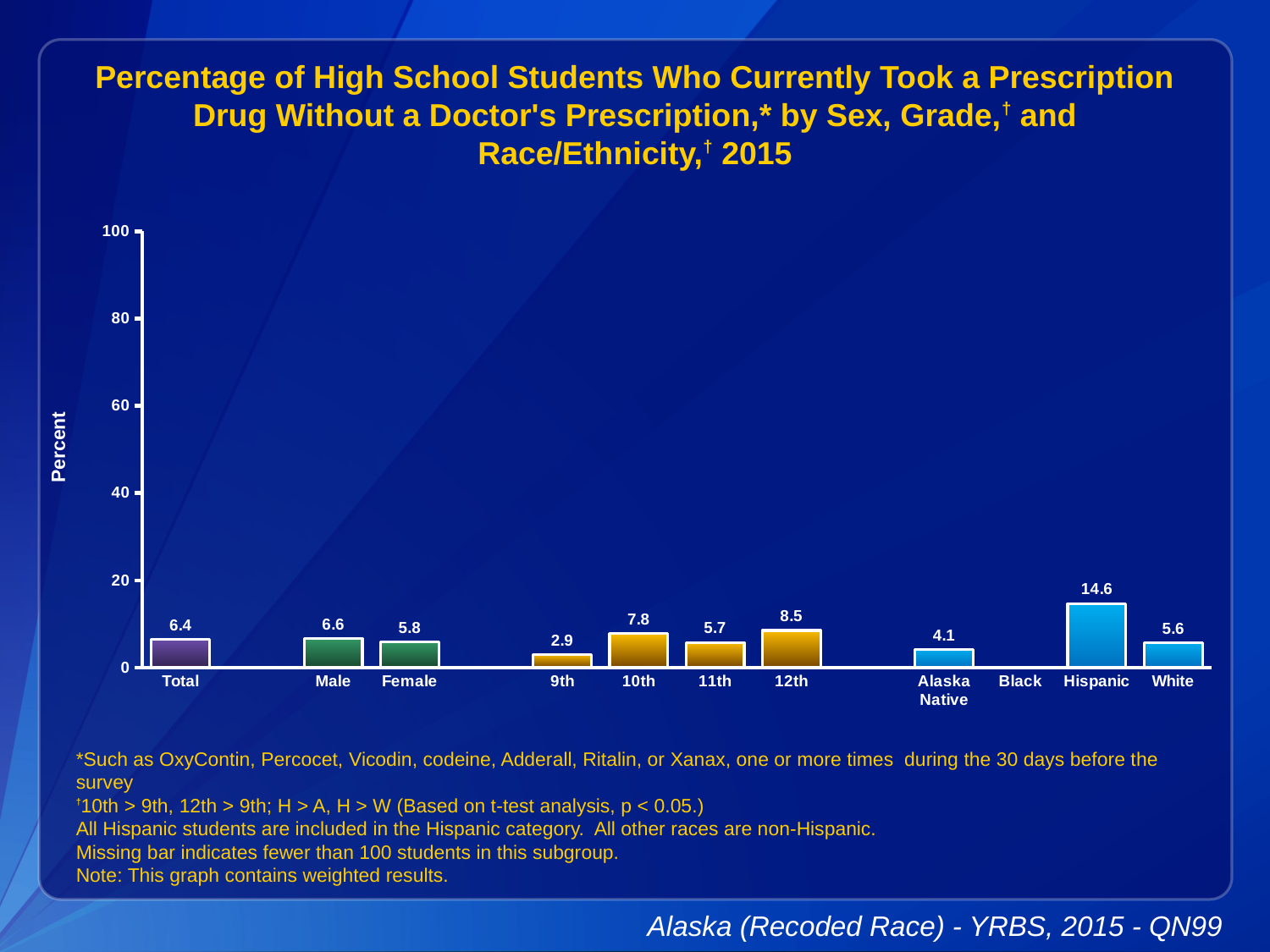
What is the difference between the Male and Female values? 0.8 What kind of chart is shown? bar chart Is the value for Hispanic students greater or less than 20? less What is the label on the y axis? Percent Which category has no bar shown? Black What is the value for Total? 6.4 How many bars are plotted on the chart? 10 What is the value for Hispanic students? 14.6 Which category has the highest value? Hispanic Which category has the lowest plotted value? 9th Which is larger, the value for 10th grade or the value for 12th grade? 12th What is the value for 9th grade students? 2.9